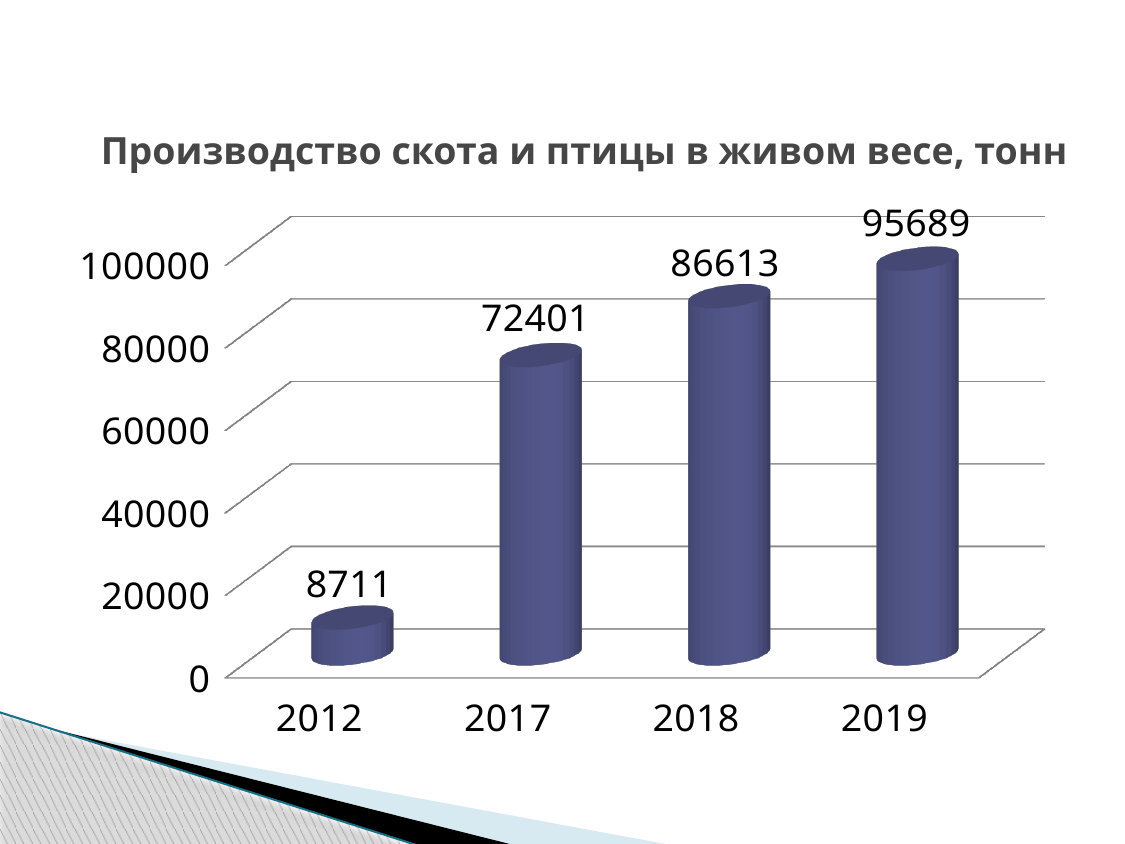
What kind of chart is this? bar chart Do the values rise or fall from 2012 to 2019? rise What is the difference between the values for 2017 and 2012? 63690 What is the value for 2018? 86613 Which is larger, the value for 2017 or the value for 2018? 2018 Which year has the lowest value? 2012 Which year has the highest value? 2019 What is the value for 2012? 8711 What is the difference between the values for 2019 and 2018? 9076 What is the value for 2017? 72401 What is the value for 2019? 95689 How many years are shown on the chart? 4